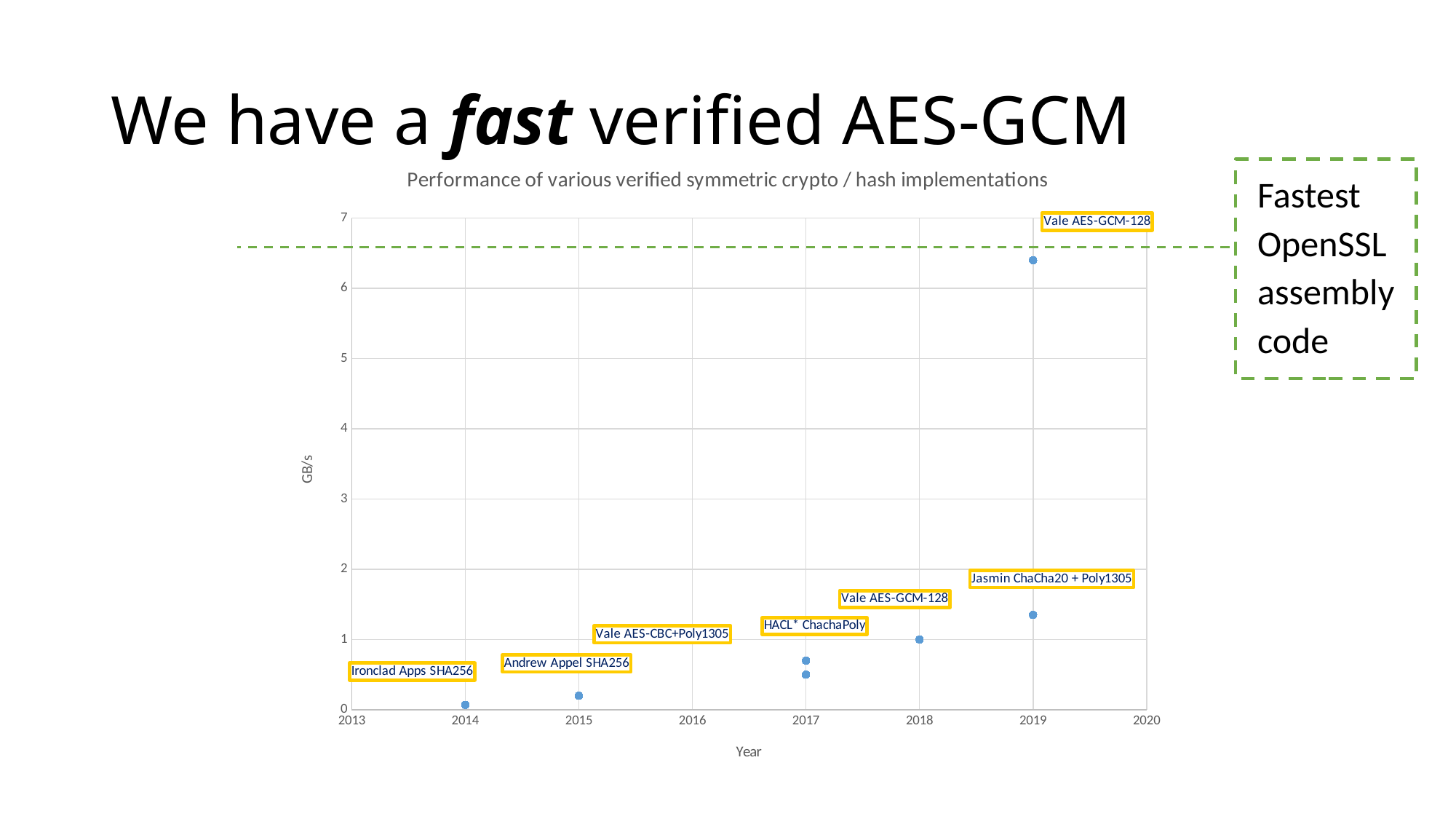
Which is larger, the value for Andrew Appel SHA256 or the value for Ironclad Apps SHA256? Andrew Appel SHA256 What is the label of the y axis? GB/s Which implementation has the lowest value on the chart? Ironclad Apps SHA256 What is the title of the chart? Performance of various verified symmetric crypto / hash implementations How many data points are plotted on the chart? 7 Do the plotted values generally rise or fall as the year increases? Rise Which is larger, the value for Jasmin ChaCha20 + Poly1305 or the value for HACL* ChachaPoly? Jasmin ChaCha20 + Poly1305 Which implementation has the highest value on the chart? Vale AES-GCM-128 (2019) Is the value for Jasmin ChaCha20 + Poly1305 greater or less than 2? less Is the value for the 2019 Vale AES-GCM-128 point greater or less than 6? greater Is the value for Ironclad Apps SHA256 greater or less than 1? less What kind of chart is shown on the slide? Scatter chart